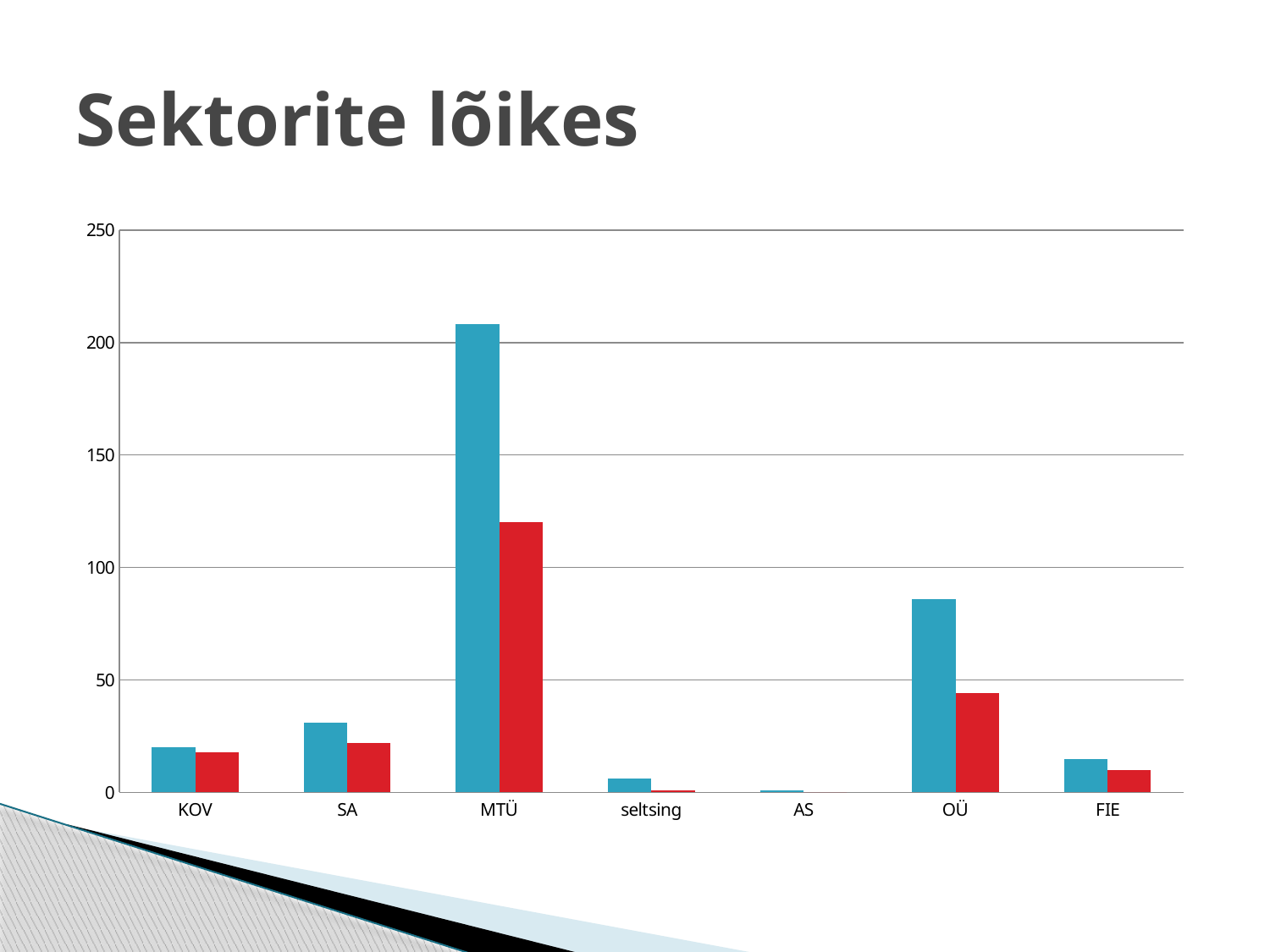
Which has the taller blue bar, OÜ or SA? OÜ Is the blue bar for MTÜ greater or less than 200? greater Which category has the tallest red bar? MTÜ How many categories are shown on the x axis? 7 Is the red bar for OÜ greater or less than 50? less Which category has the shortest blue bar? AS Which has the taller red bar, KOV or OÜ? OÜ How many differently coloured bar series are plotted for each category? 2 Is the red bar for MTÜ greater or less than 100? greater Which category has the tallest blue bar? MTÜ What kind of chart is shown on the slide? bar chart